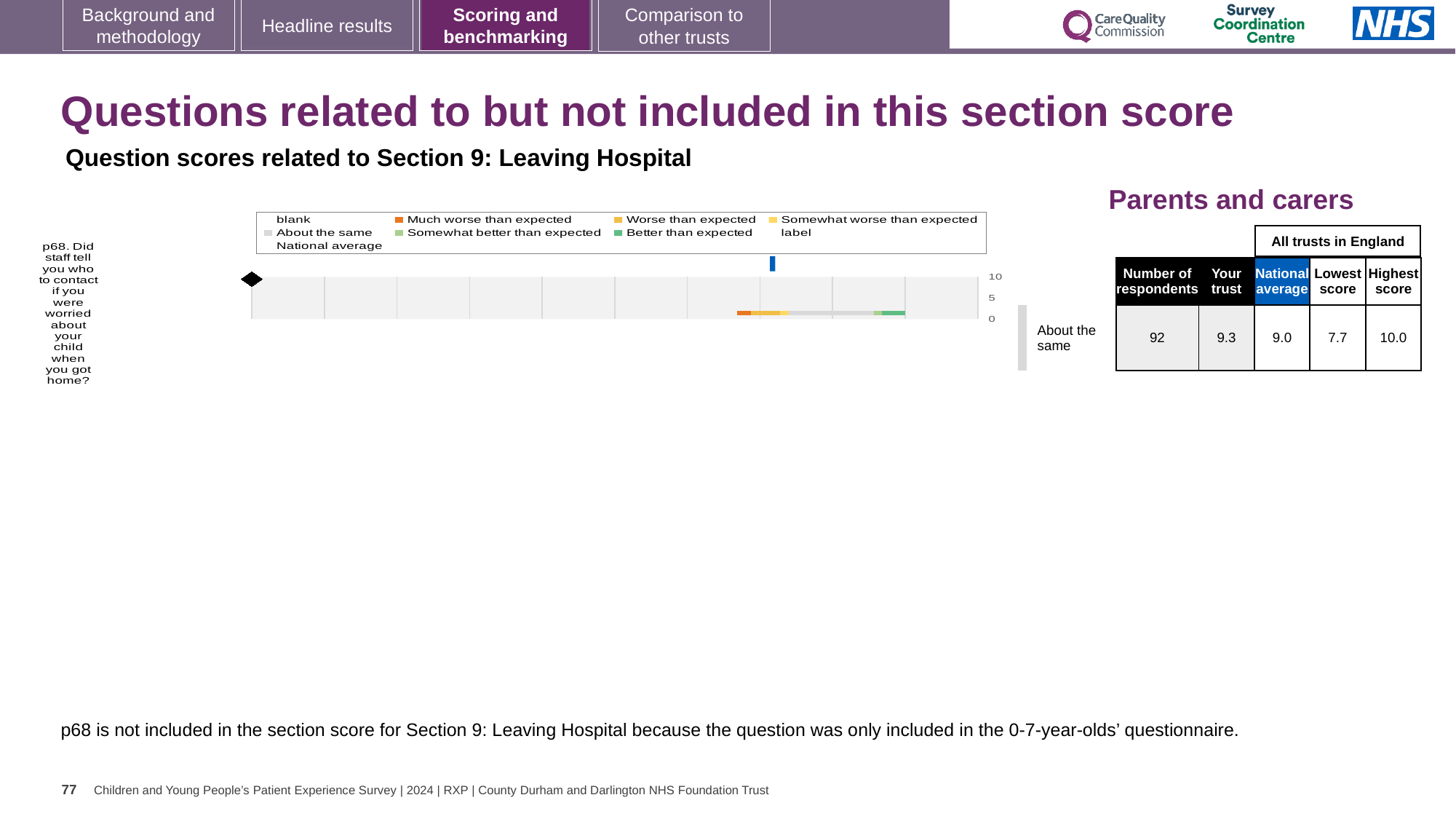
Which colour represents 'Much worse than expected' in the chart legend? orange What is the 'Your trust' score for question p68? 9.3 How many questions are plotted in the chart? 1 What is the lowest score among all trusts in England for question p68? 7.7 What benchmarking category is shown for question p68 in the chart? About the same What is the highest value shown on the chart's axis? 10 What is the national average score for question p68? 9.0 How many entries does the chart legend list? 9 Which is larger for question p68, the 'Your trust' score or the national average? Your trust What is the highest score among all trusts in England for question p68? 10.0 How many respondents answered question p68? 92 What kind of chart is shown on the slide for question p68? bar chart